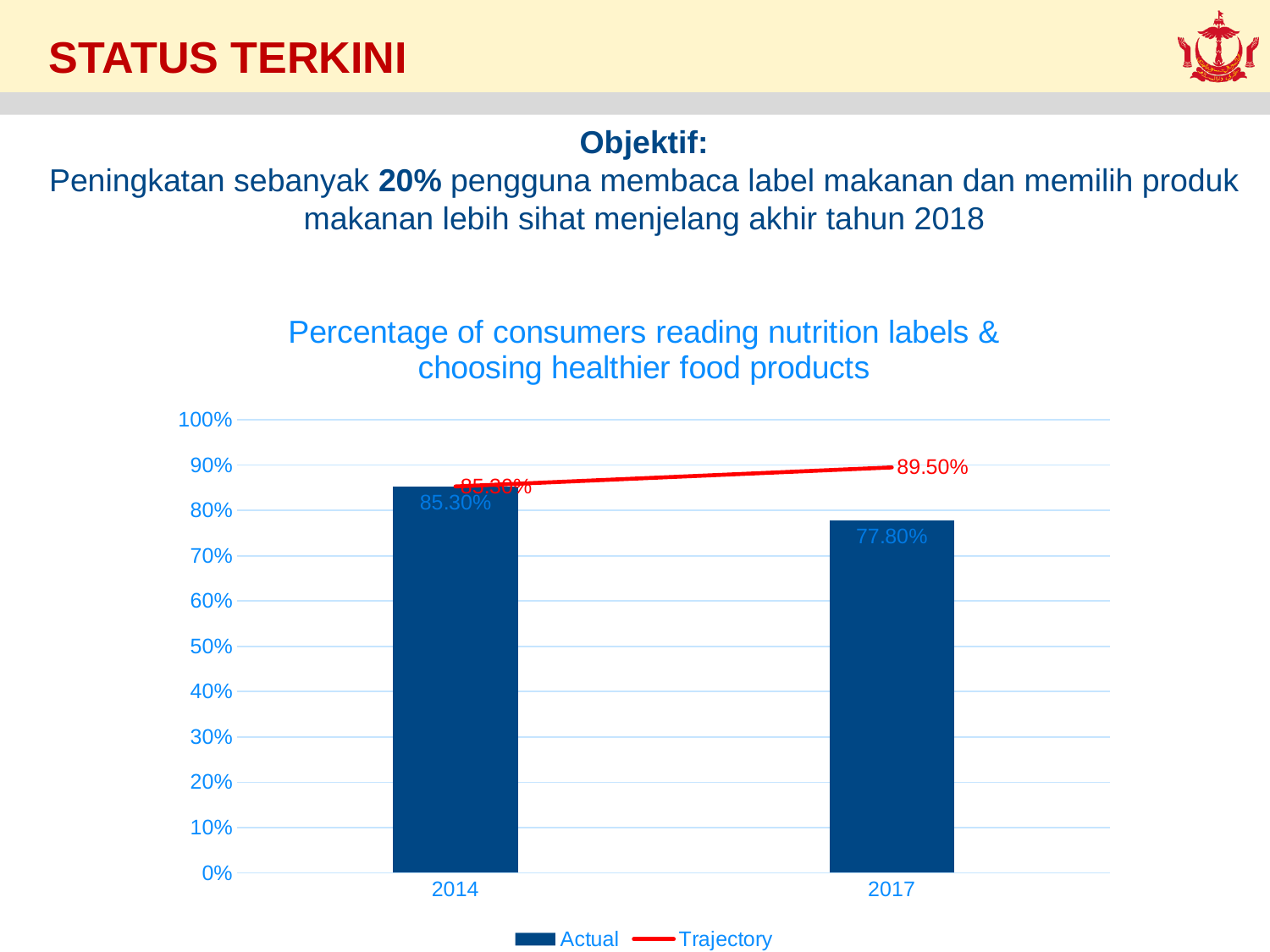
Which year has the higher Actual value, 2014 or 2017? 2014 What is the Trajectory value for 2017? 89.50% What is the difference between the Actual values for 2014 and 2017? 7.50% Is the Actual value for 2017 greater or less than 80%? less What is the Actual value for 2017? 77.80% How many years are shown on the x axis? 2 What is the difference between the Trajectory value and the Actual value for 2017? 11.70% Does the Actual value rise or fall from 2014 to 2017? fall How many series does the legend list? 2 Which year has the lowest Actual value? 2017 What is the title of the chart? Percentage of consumers reading nutrition labels & choosing healthier food products What is the Actual value for 2014? 85.30%